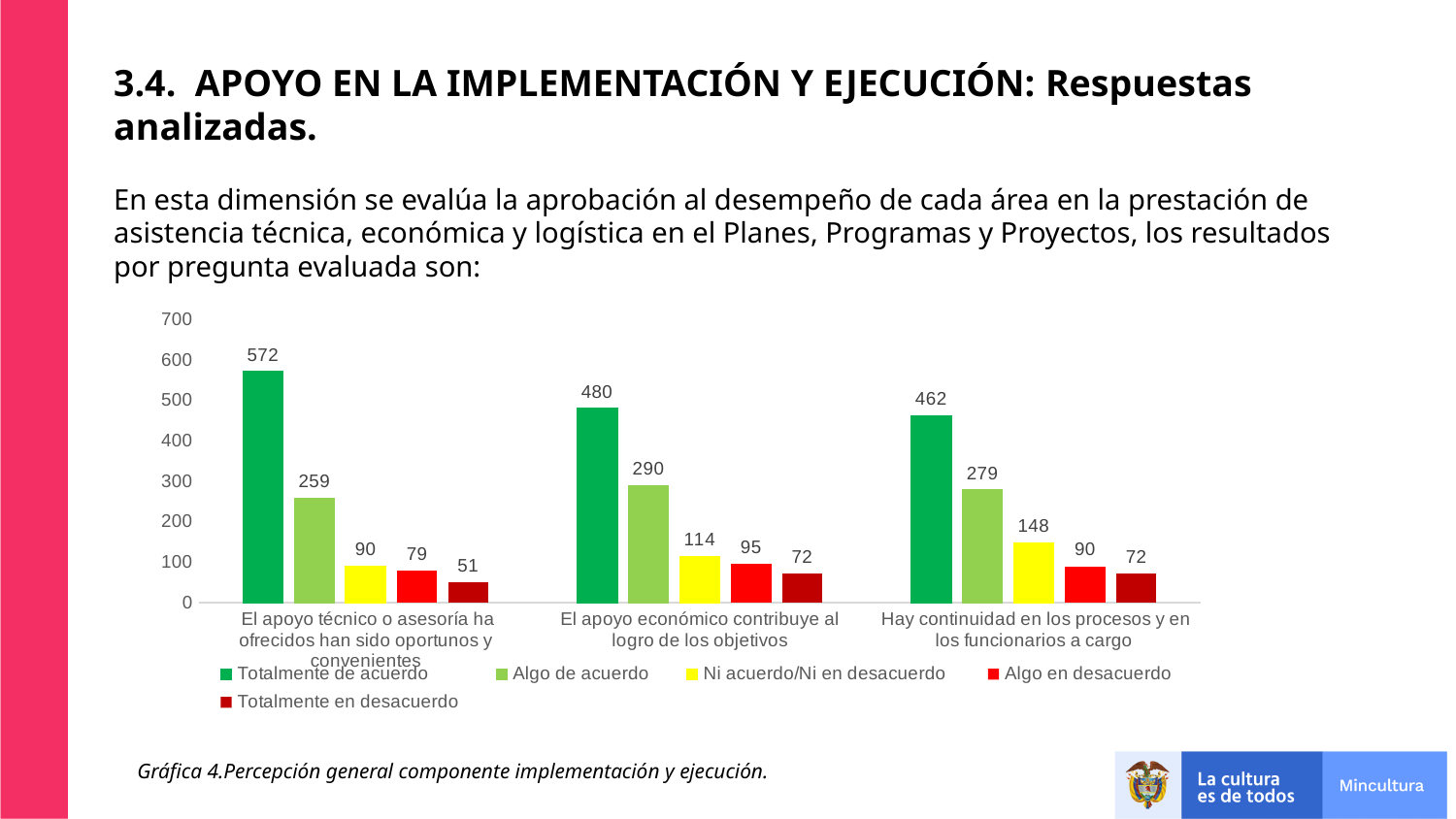
Which category has the lowest "Algo de acuerdo" value? El apoyo técnico o asesoría ha ofrecidos han sido oportunos y convenientes What is the difference between the "Totalmente de acuerdo" values for "El apoyo técnico o asesoría ha ofrecidos han sido oportunos y convenientes" and "El apoyo económico contribuye al logro de los objetivos"? 92 What is the value of "Totalmente en desacuerdo" for "El apoyo técnico o asesoría ha ofrecidos han sido oportunos y convenientes"? 51 What is the value of "Ni acuerdo/Ni en desacuerdo" for "Hay continuidad en los procesos y en los funcionarios a cargo"? 148 Which category has the highest "Totalmente de acuerdo" value? El apoyo técnico o asesoría ha ofrecidos han sido oportunos y convenientes Is the "Totalmente de acuerdo" value for "Hay continuidad en los procesos y en los funcionarios a cargo" greater or less than 500? less What type of chart is shown on the slide? Bar chart What is the value of "Totalmente de acuerdo" for "El apoyo económico contribuye al logro de los objetivos"? 480 How many series does the legend list? 5 What colour represents the "Ni acuerdo/Ni en desacuerdo" series? Yellow How many categories (questions) are shown on the x axis? 3 Which is larger: "Algo en desacuerdo" for "El apoyo económico contribuye al logro de los objetivos" or "Algo en desacuerdo" for "Hay continuidad en los procesos y en los funcionarios a cargo"? El apoyo económico contribuye al logro de los objetivos